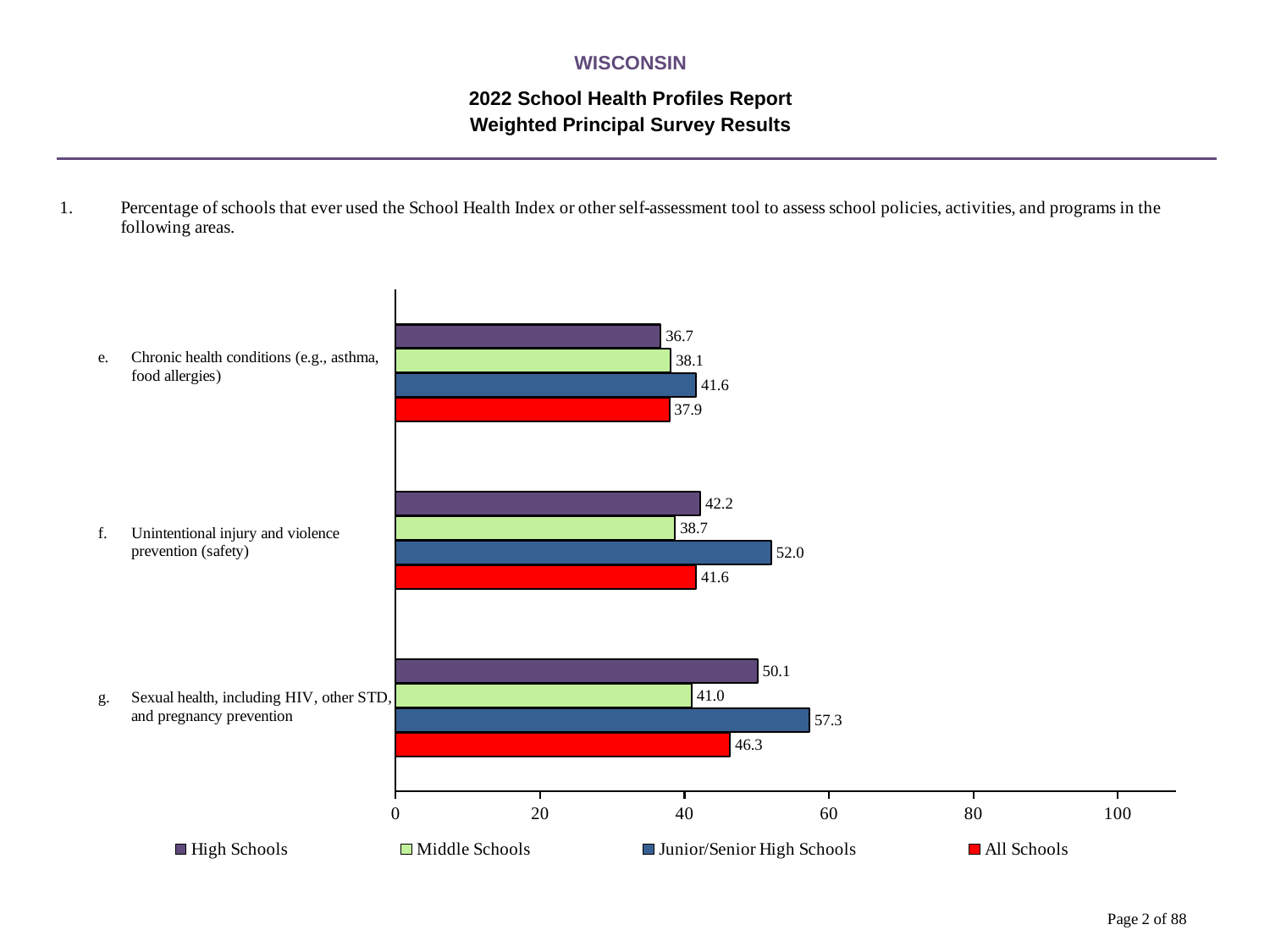
What is the value for Junior/Senior High Schools for sexual health, including HIV, other STD, and pregnancy prevention? 57.3 Which colour represents All Schools in the legend? Red Which is larger for unintentional injury and violence prevention (safety): the High Schools value or the Middle Schools value? High Schools What kind of chart is shown on the slide? Bar chart Is the value for High Schools for sexual health, including HIV, other STD, and pregnancy prevention greater or less than 40? greater What is the value for All Schools for unintentional injury and violence prevention (safety)? 41.6 Which school type has the highest value for unintentional injury and violence prevention (safety)? Junior/Senior High Schools What is the value for Middle Schools for chronic health conditions (e.g., asthma, food allergies)? 38.1 What is the difference between the Junior/Senior High Schools and Middle Schools values for sexual health, including HIV, other STD, and pregnancy prevention? 16.3 How many areas (categories) are shown on the chart? 3 Which school type has the lowest value for chronic health conditions (e.g., asthma, food allergies)? High Schools How many series does the legend list? 4